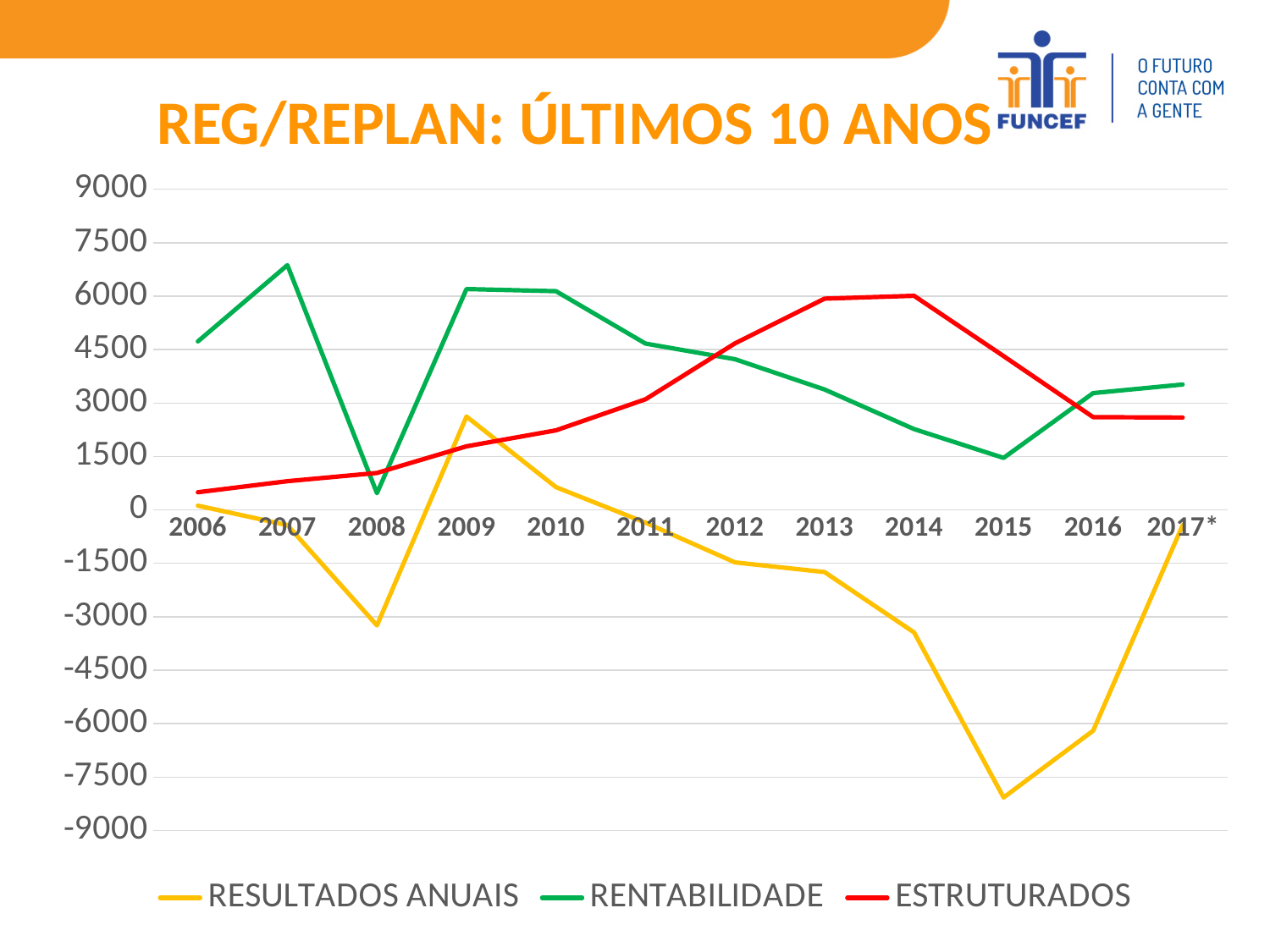
Is the value for RESULTADOS ANUAIS in 2015 greater or less than -7500? less Does the ESTRUTURADOS line rise or fall from 2006 to 2014? Rise What type of chart is shown on the slide? Line chart In which year does RENTABILIDADE reach its highest value? 2007 How many years are shown on the x axis? 12 Is the value for RENTABILIDADE in 2007 greater or less than 6000? greater In which year does RESULTADOS ANUAIS reach its lowest value? 2015 How many series does the legend list? 3 Is the value for ESTRUTURADOS in 2008 greater or less than 1500? less In 2013, which series has the higher value, ESTRUTURADOS or RENTABILIDADE? ESTRUTURADOS In which year is ESTRUTURADOS at its lowest value? 2006 In which year does RENTABILIDADE reach its lowest value? 2008